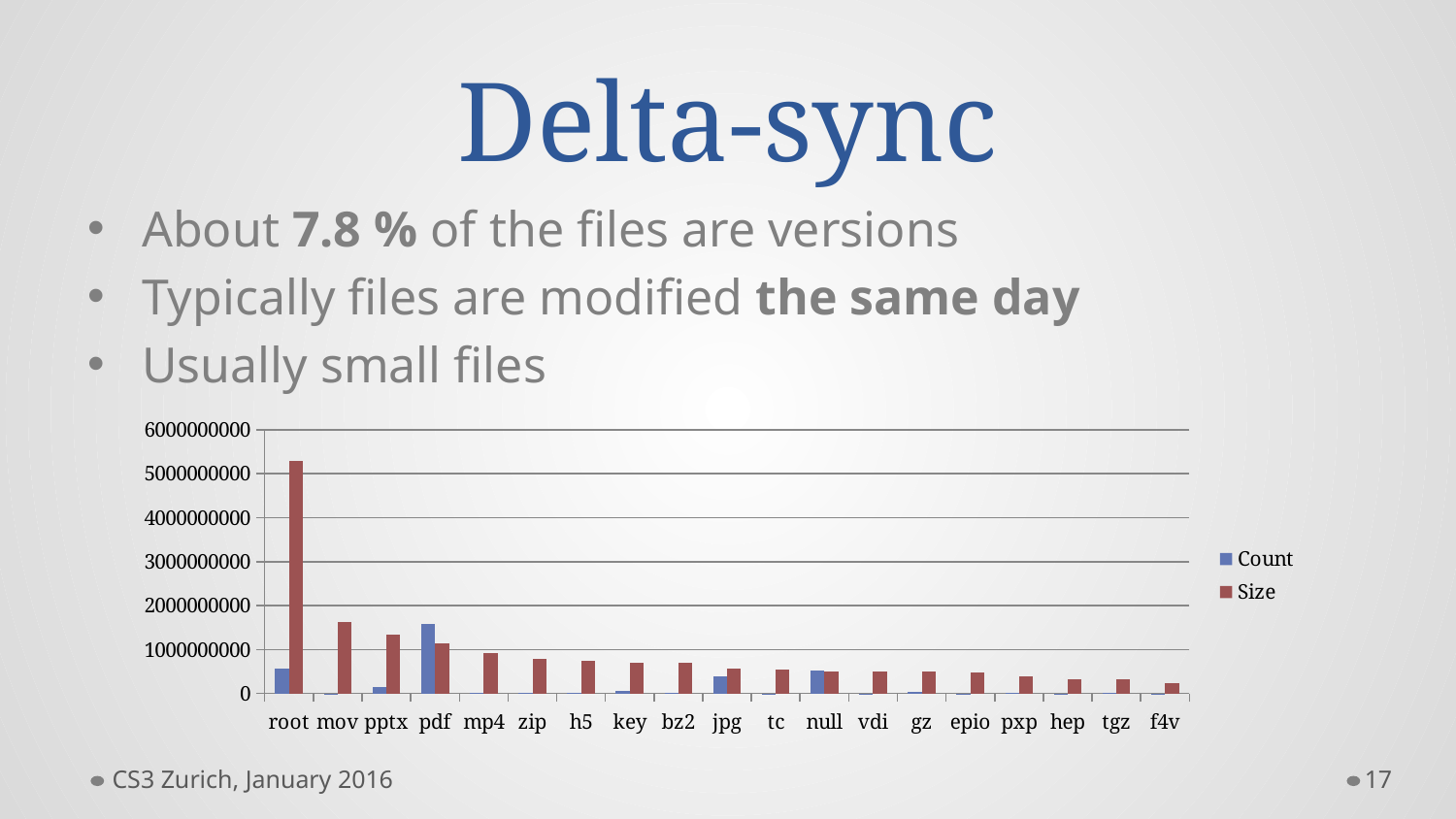
Is the Size value for root greater or less than 5000000000? greater What kind of chart is shown on the slide? bar chart How many series does the chart legend list? 2 How many file-type categories are shown on the x axis of the chart? 19 Is the Count value for root greater or less than 1000000000? less Which is larger, the Size value for root or the Size value for mov? root What are the two series named in the chart legend? Count and Size Which category has the highest Size value? root Which category has the highest Count value? pdf Is the Count value for pdf greater or less than 1000000000? greater Do the Size values generally rise or fall moving from left to right along the x axis? fall